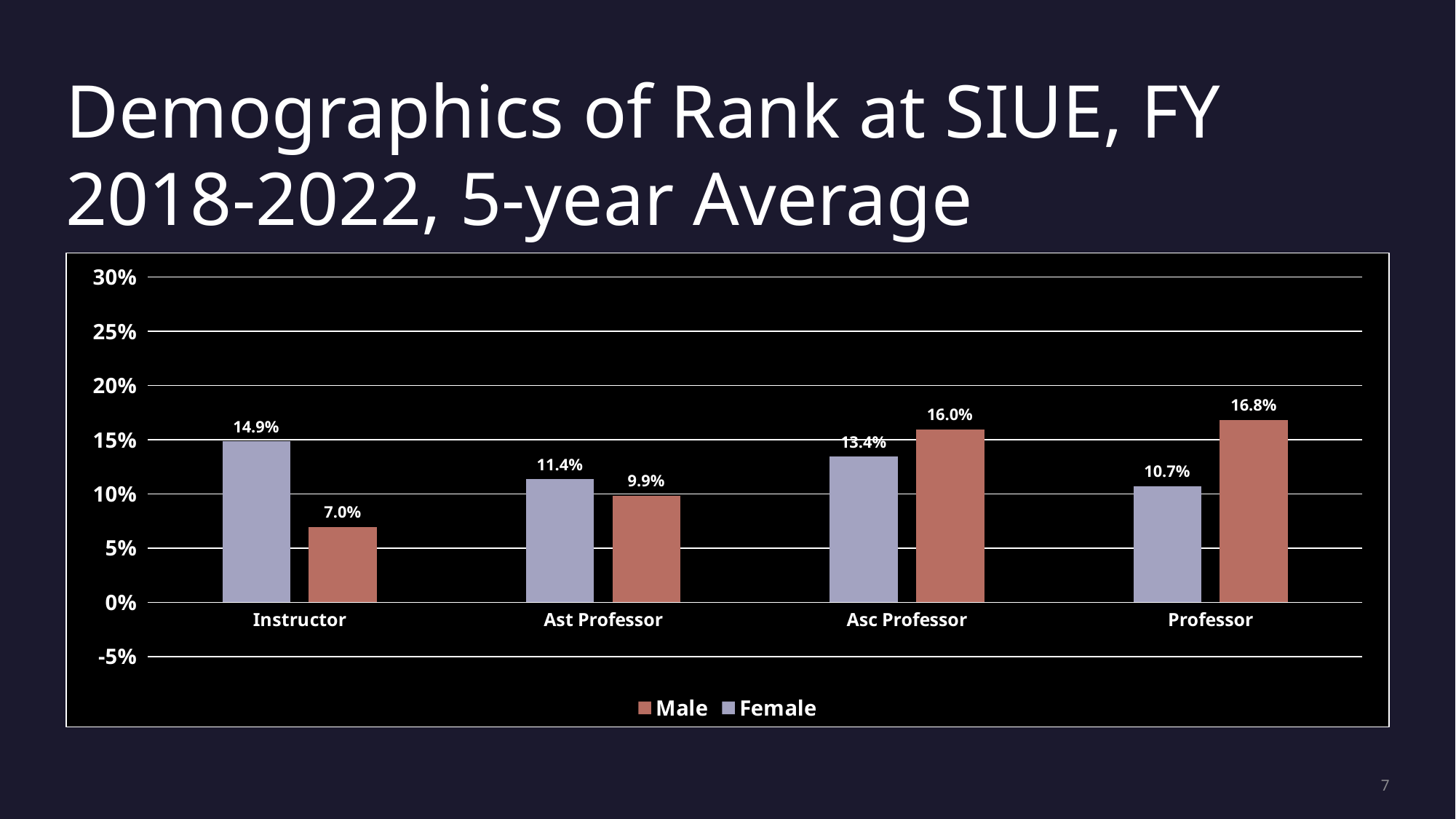
What is the difference between the Female and Male values for Instructor? 7.9% How many rank categories are shown on the x axis? 4 What is the Female value for Asc Professor? 13.4% What is the Male value for Professor? 16.8% What kind of chart is shown on the slide? Bar chart Which is larger for Asc Professor, the Male value or the Female value? Male Which rank has the highest Male value? Professor Which rank has the lowest Female value? Professor What is the Male value for Ast Professor? 9.9% Do the Male values rise or fall from Instructor to Professor along the x axis? Rise How many series does the legend list? 2 What is the Female value for Instructor? 14.9%